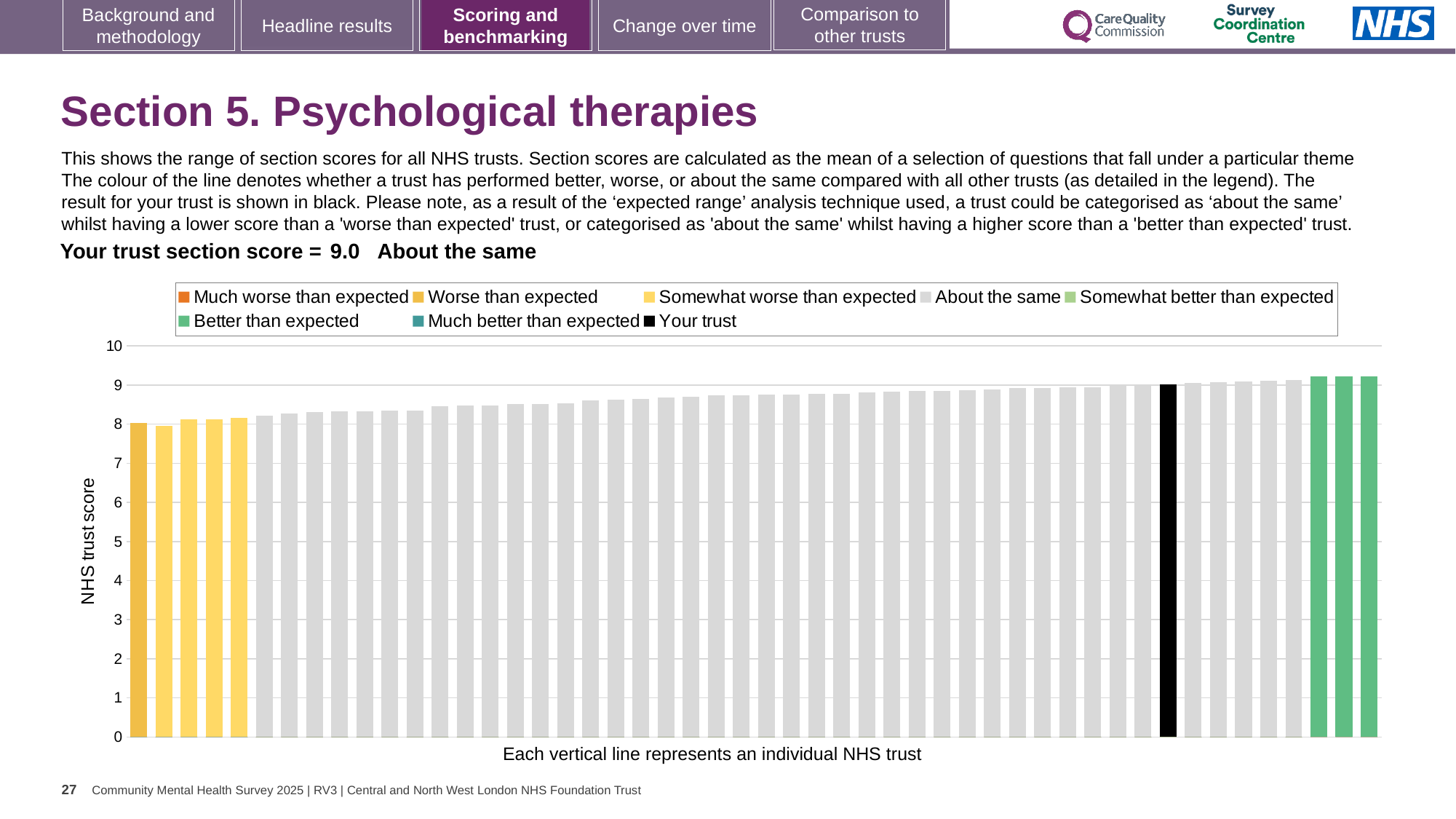
Is the value for your trust (the black bar) greater or less than 8? greater What kind of chart is shown on the slide? Bar chart Is the value for the rightmost bar greater or less than 8? greater What is the section score for your trust shown on the slide? 9.0 Which is larger: the value for your trust (black bar) or the value for the leftmost bar? Your trust Do the bar values rise or fall from left to right along the x axis? rise How many bars are shown in black for your trust? 1 What is the label on the vertical axis of the chart? NHS trust score Is the value for the leftmost bar greater or less than 9? less How many entries does the chart legend list? 8 How many bars are coloured green (Better than expected)? 3 How is your trust's section score categorised compared with other trusts? About the same